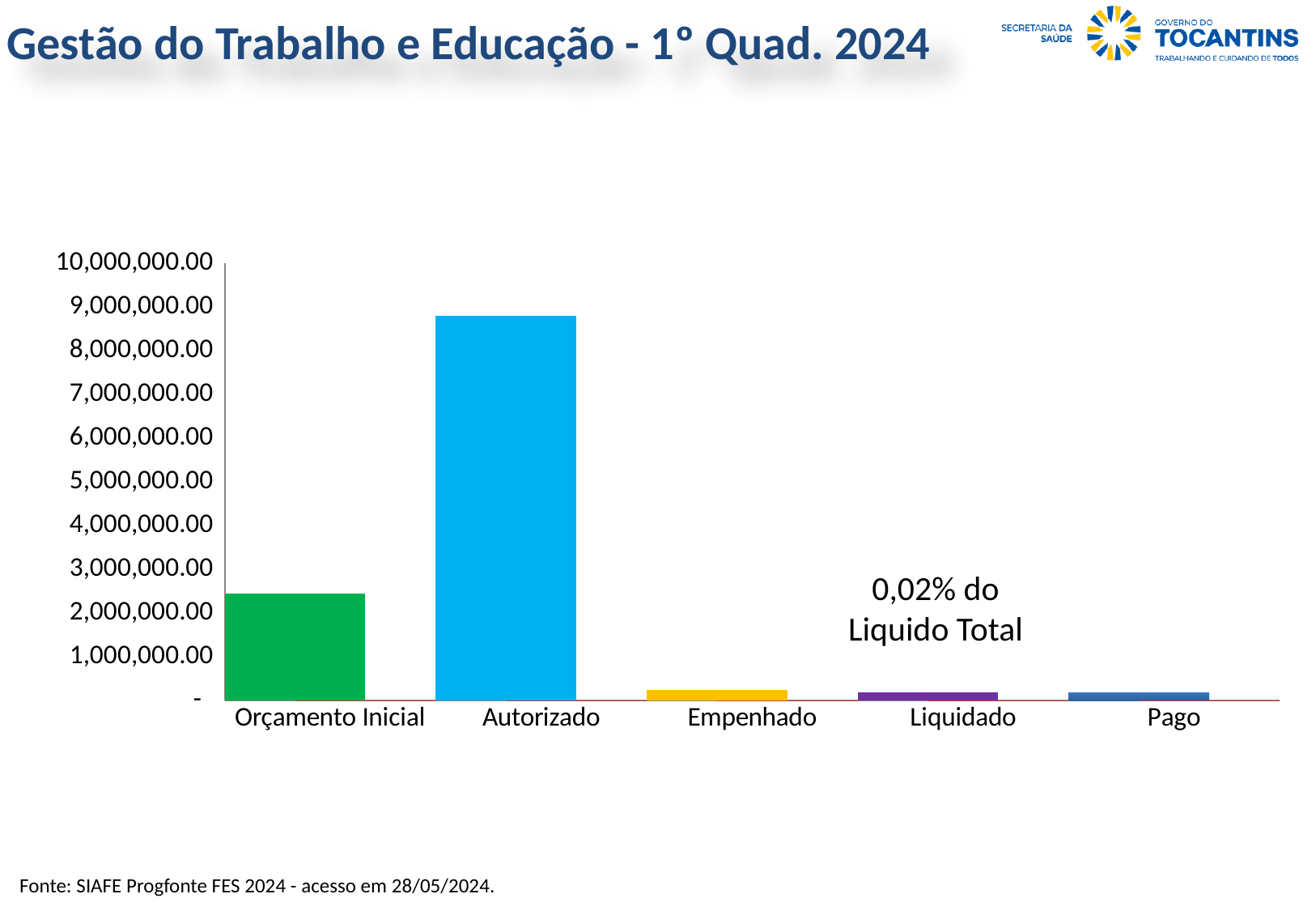
Which is larger, the value for Orçamento Inicial or the value for Autorizado? Autorizado Is the value for Autorizado greater or less than 8,000,000.00? greater Is the value for Autorizado greater or less than 9,000,000.00? less Which is larger, the value for Empenhado or the value for Orçamento Inicial? Orçamento Inicial Is the value for Orçamento Inicial greater or less than 2,000,000.00? greater What is the title of the slide containing the chart? Gestão do Trabalho e Educação - 1° Quad. 2024 Which category has the highest value in the chart? Autorizado What percentage annotation is printed above the Liquidado bar? 0,02% do Liquido Total How many categories are shown on the x axis of the chart? 5 What kind of chart is shown on the slide? bar chart